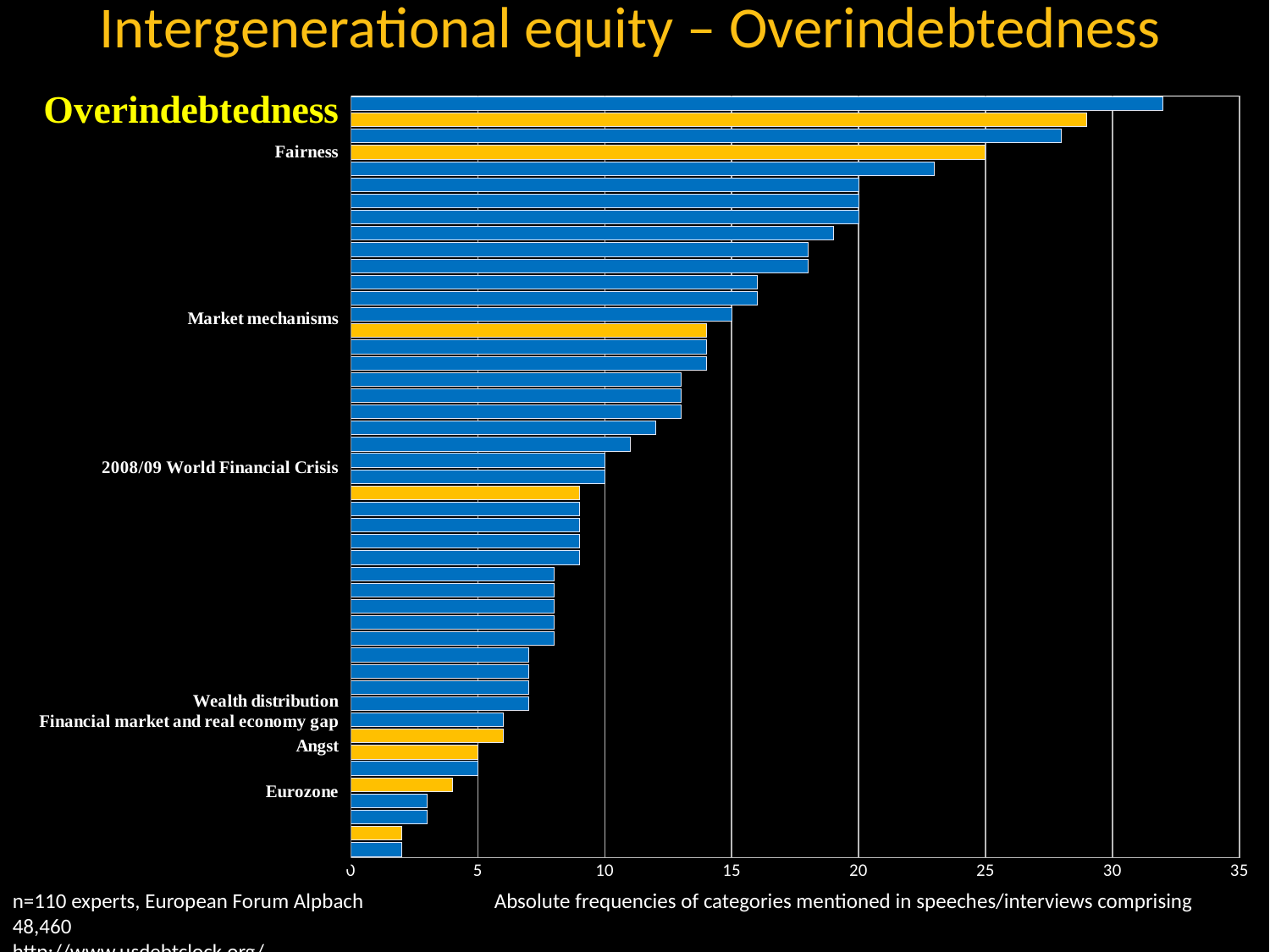
Is the value for Market mechanisms greater or less than 10? greater Is the value for Wealth distribution greater or less than 10? less Is the value for Eurozone greater or less than 5? less What kind of chart is shown on the slide? bar chart Which has the larger value, Fairness or Market mechanisms? Fairness Which labeled category has the longest bar? Overindebtedness What is the highest value shown on the horizontal axis? 35 Which has the larger value, Eurozone or Wealth distribution? Wealth distribution